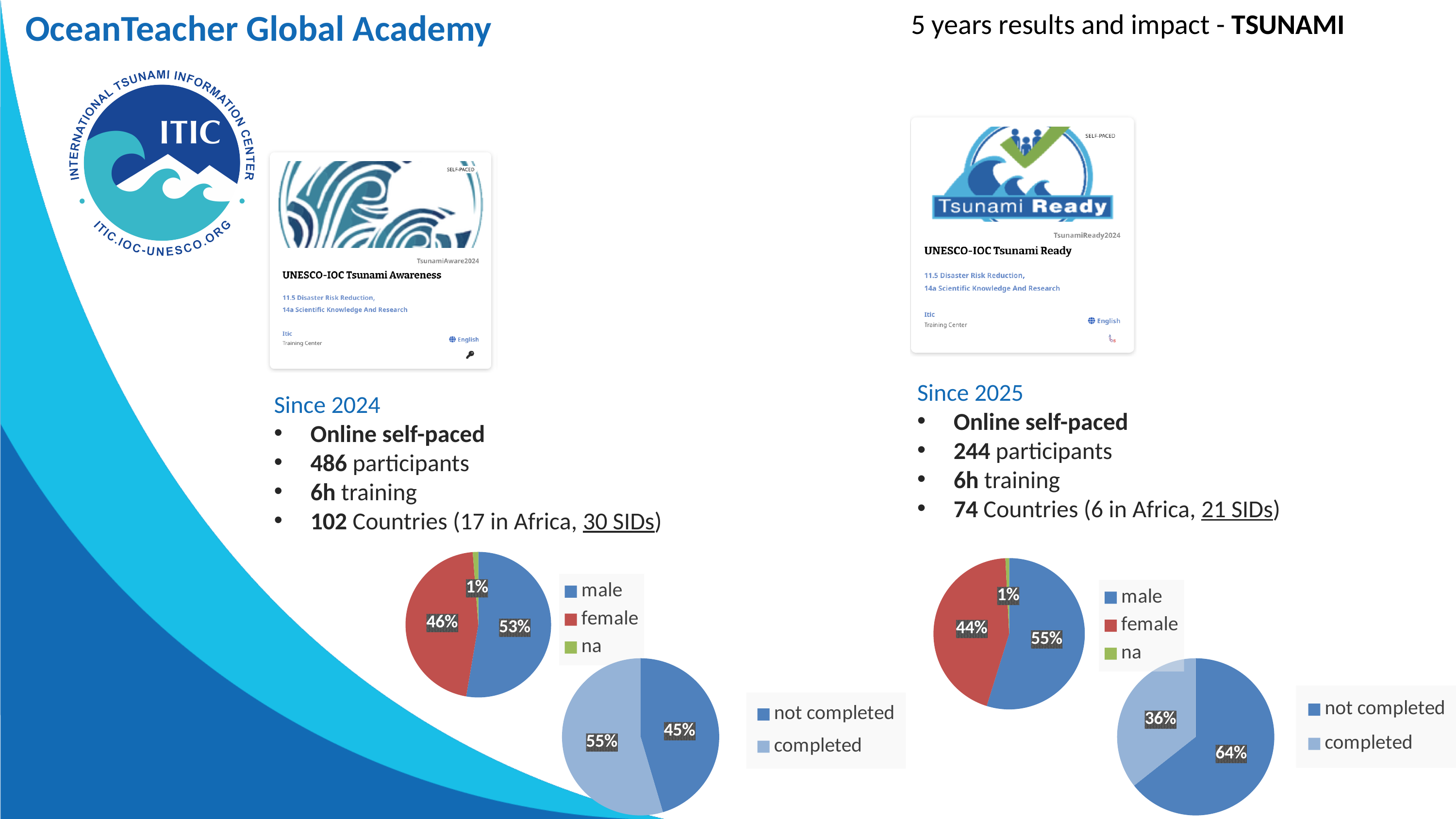
In the completion pie chart under the Tsunami Awareness course (left side), what share is completed? 55% In the completion pie chart under the Tsunami Ready course (right side), what is the difference between the not completed and completed shares? 28% In the completion pie chart under the Tsunami Ready course (right side), what share is not completed? 64% In the gender pie chart under the Tsunami Ready course (right side), which category has the largest share? male How many categories does the legend of the gender pie chart under the Tsunami Ready course (right side) list? 3 In the completion pie chart under the Tsunami Awareness course (left side), which is larger, completed or not completed? completed In the gender pie chart under the Tsunami Ready course (right side), what share is female? 44% In the gender pie chart under the Tsunami Awareness course (left side), which category has the smallest share? na In the gender pie chart under the Tsunami Awareness course (left side), what share is female? 46% In the gender pie chart under the Tsunami Awareness course (left side), what share is male? 53% In the gender pie chart under the Tsunami Awareness course (left side), what colour represents female? red What type of chart is used to show the completion status under the Tsunami Awareness course (left side)? pie chart